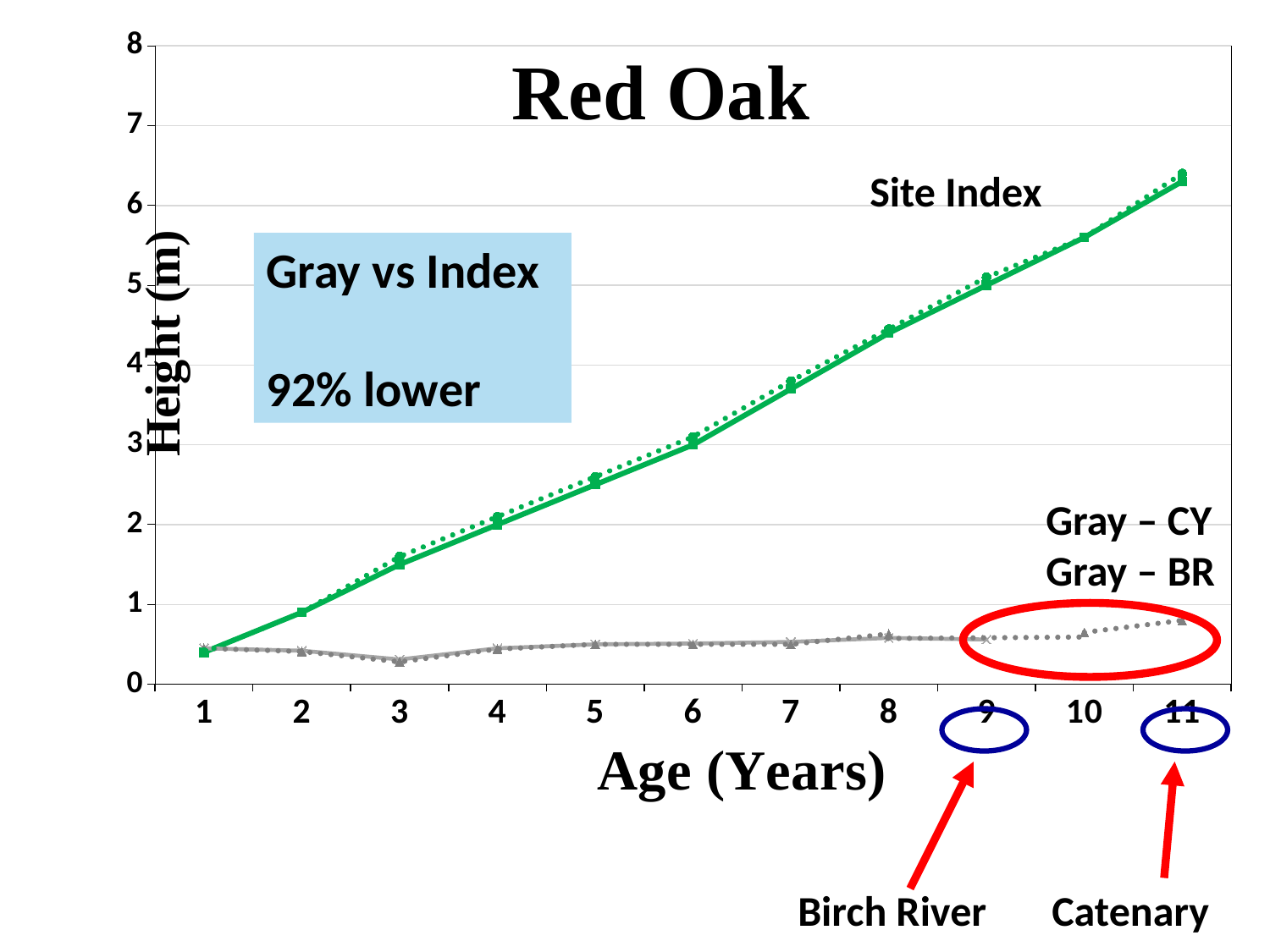
At age 8, which is higher: the Site Index line or the Gray line? Site Index Is the Site Index height at age 6 greater or less than 2 m? greater According to the text box on the chart, by how much is Gray lower than the Index? 92% lower Is the Gray height at age 11 greater or less than 1 m? less What kind of chart is shown on the slide? line chart Is the Site Index height at age 11 greater or less than 6 m? greater What is the title of the chart? Red Oak At which age is the Site Index height lowest? 1 At which age does the Site Index line reach its highest height? 11 Does the Site Index line rise or fall as age increases from 1 to 11 years? rises How many age values are shown along the x axis? 11